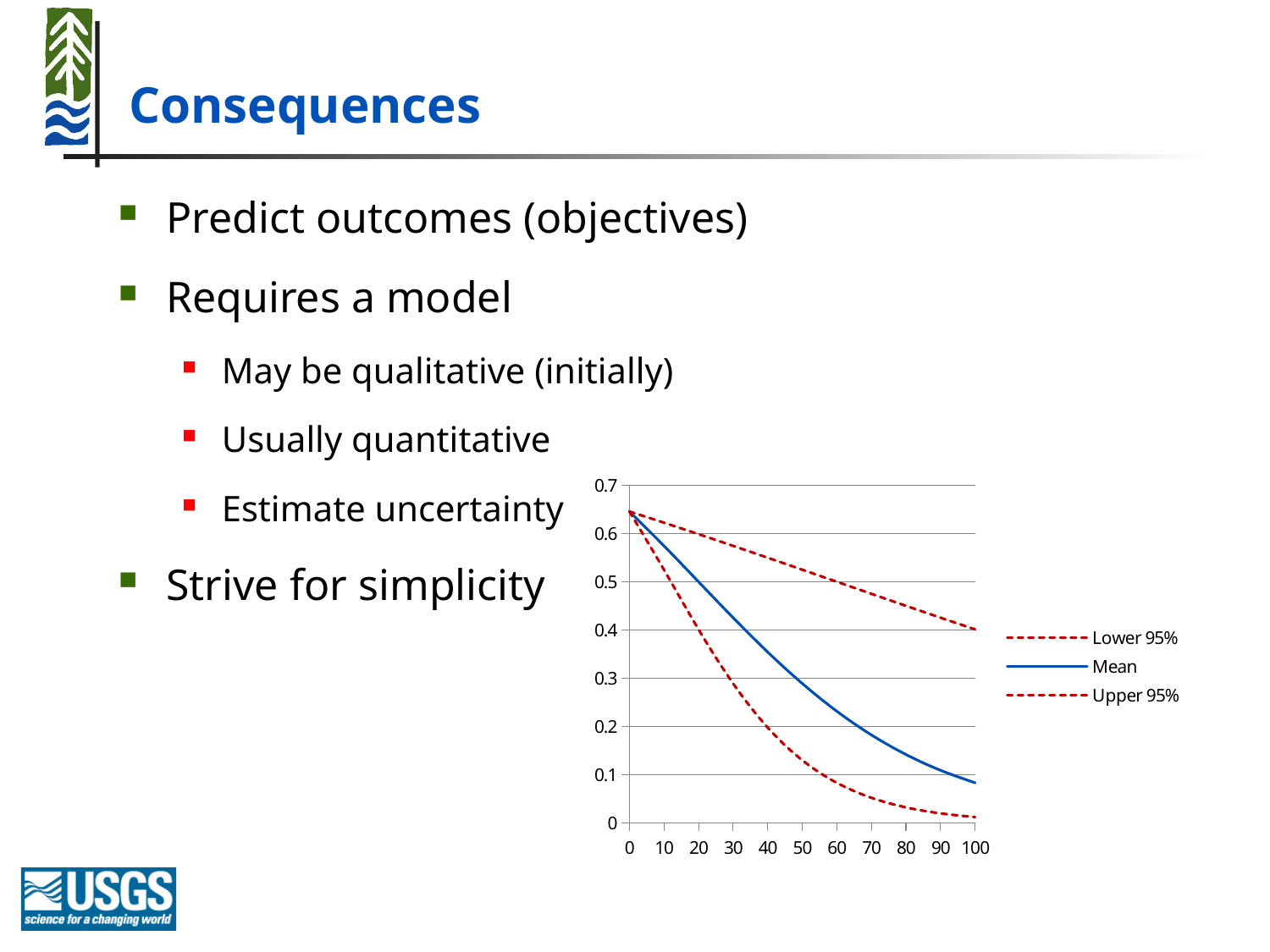
Is the value of the Mean line at x = 40 greater or less than 0.3? greater Does the Mean line rise or fall as the x axis goes from 0 to 100? fall What are the three series named in the chart's legend? Lower 95%, Mean, Upper 95% Is the value of the Mean line at x = 100 greater or less than 0.1? less What colour is the Mean line in the chart? blue Is the value of the Mean line at x = 80 greater or less than 0.2? less How many series does the chart's legend list? 3 What kind of chart is shown on the slide? line chart What is the highest value labelled on the chart's y axis? 0.7 How many tick labels are shown along the chart's x axis? 11